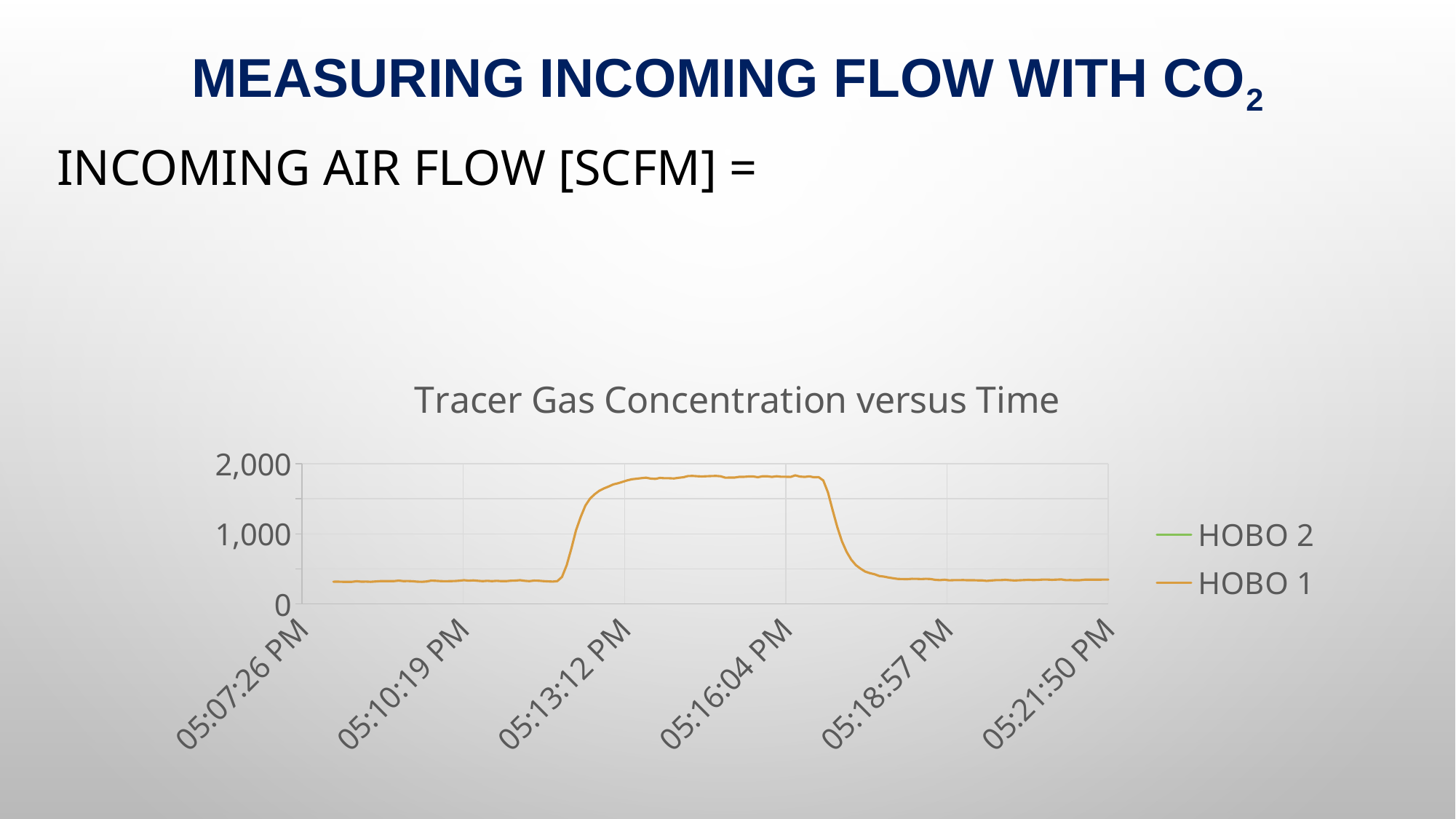
Which series is drawn in orange in the chart? HOBO 1 How many series does the chart legend list? 2 Is the HOBO 1 value at 05:21:50 PM greater or less than 1,000? less What is the title of the chart? Tracer Gas Concentration versus Time How many time labels are shown on the x axis of the chart? 6 Is the HOBO 1 value at 05:10:19 PM greater or less than 1,000? less Is the highest HOBO 1 value on the chart greater or less than 2,000? less Does the HOBO 1 line rise or fall between 05:16:04 PM and 05:18:57 PM? fall What kind of chart is shown on the slide? line chart Which is larger for HOBO 1: the value at 05:16:04 PM or the value at 05:18:57 PM? 05:16:04 PM Does the HOBO 1 line rise or fall between 05:10:19 PM and 05:16:04 PM? rise